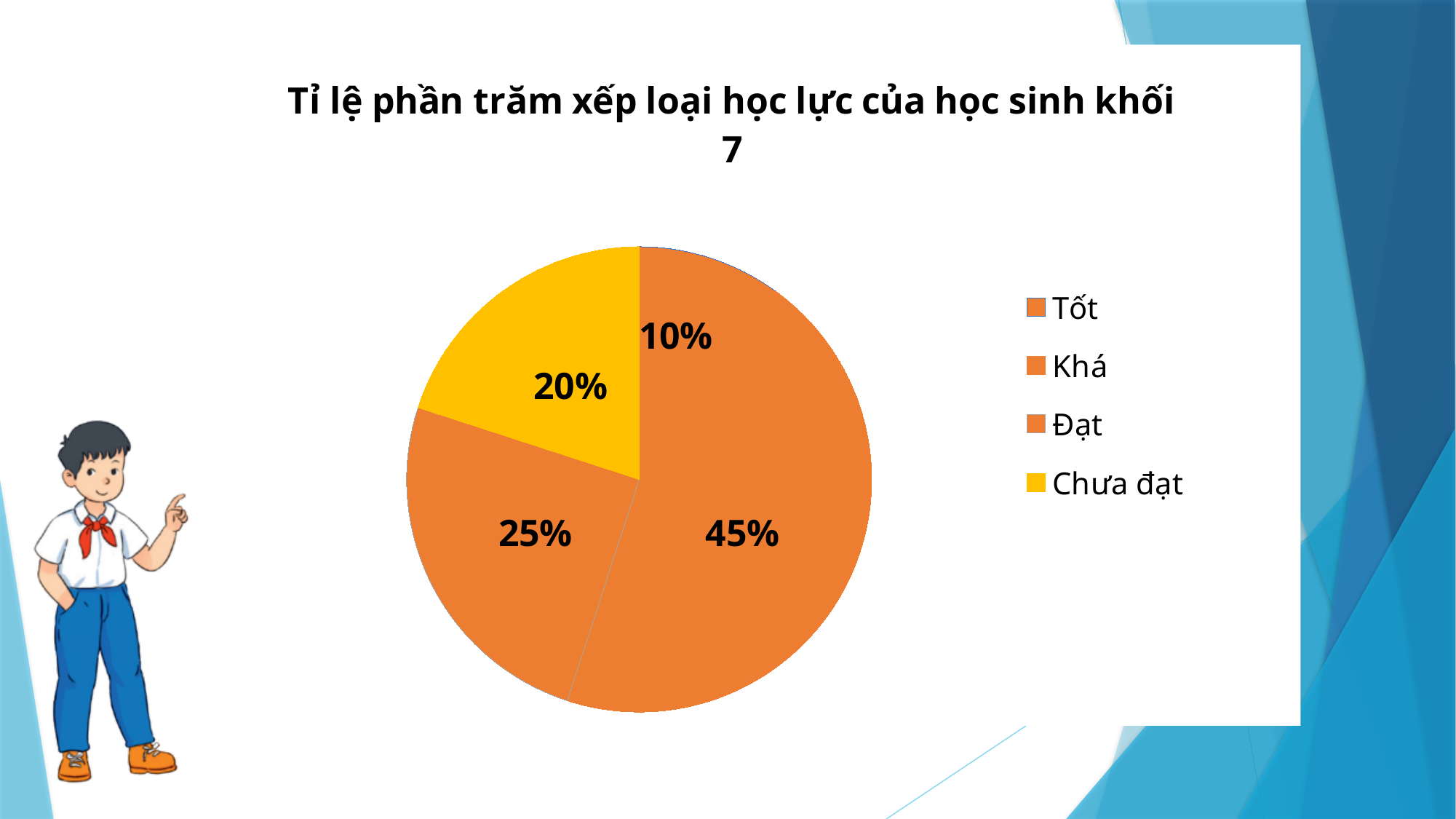
What percentage of students are rated "Tốt"? 10% What kind of chart is shown on the slide? pie chart What percentage of students are rated "Khá"? 45% Which category has the smallest share of the pie? Tốt What is the title of the chart? Tỉ lệ phần trăm xếp loại học lực của học sinh khối 7 What percentage of students are rated "Chưa đạt"? 20% Which is larger, the "Đạt" slice or the "Chưa đạt" slice? Đạt Which category has the largest share of the pie? Khá Which category is shown in yellow in the legend? Chưa đạt What is the difference in percentage points between the "Khá" and "Đạt" slices? 20 How many categories does the pie chart show? 4 What percentage of students are rated "Đạt"? 25%